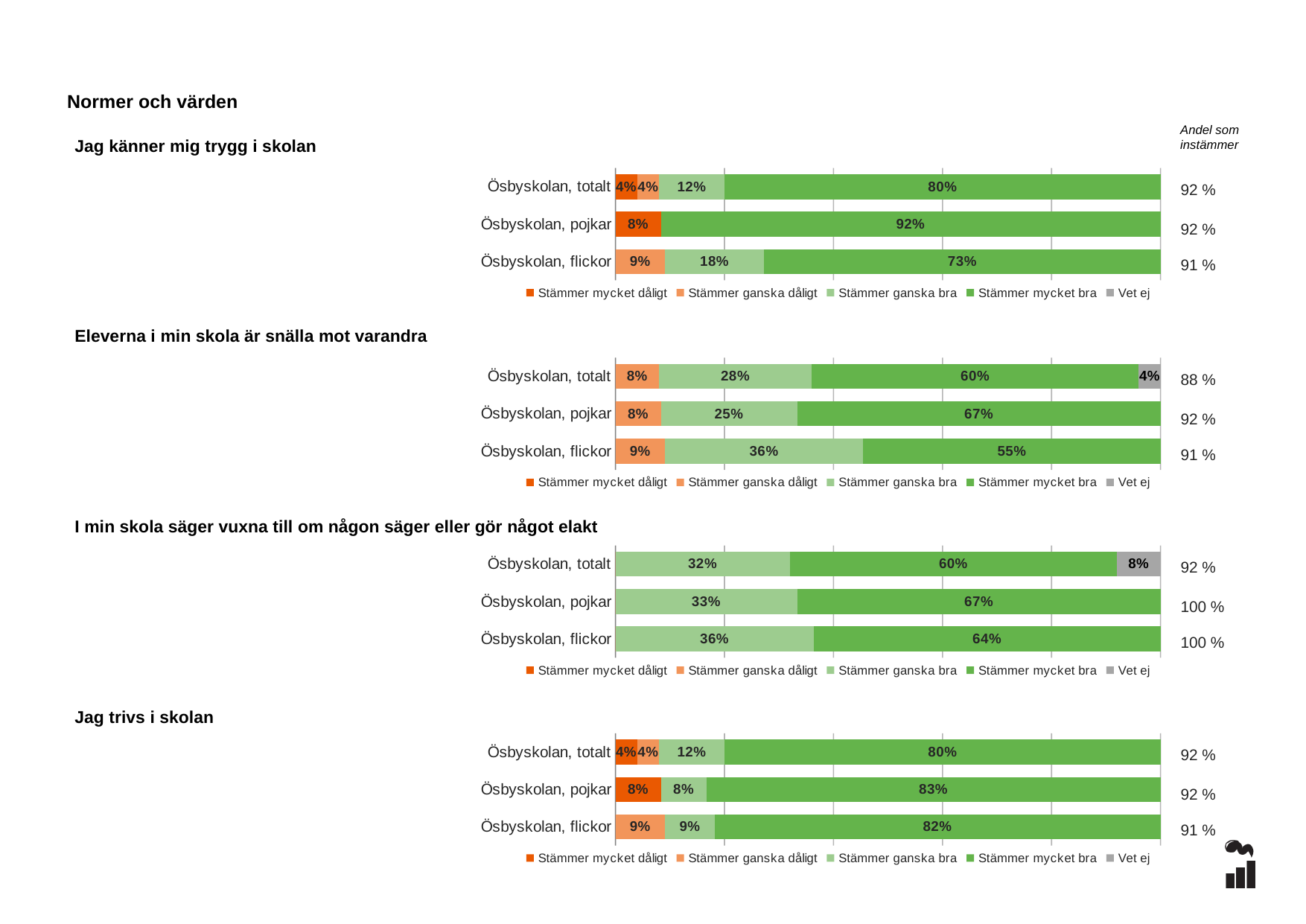
In the chart 'I min skola säger vuxna till om någon säger eller gör något elakt', what is the 'Vet ej' value for Ösbyskolan, totalt? 8% In the chart 'I min skola säger vuxna till om någon säger eller gör något elakt', which is larger: the 'Stämmer mycket bra' value for Ösbyskolan, pojkar or for Ösbyskolan, flickor? Ösbyskolan, pojkar In the chart 'Jag känner mig trygg i skolan', what is the 'Stämmer mycket bra' value for Ösbyskolan, pojkar? 92% In the chart 'Jag känner mig trygg i skolan', what is the 'Stämmer ganska bra' value for Ösbyskolan, flickor? 18% In the chart 'Jag trivs i skolan', which group has the lowest 'Stämmer mycket bra' value? Ösbyskolan, totalt In the chart 'Eleverna i min skola är snälla mot varandra', which group has the highest 'Stämmer mycket bra' value? Ösbyskolan, pojkar What type of chart is used for 'Eleverna i min skola är snälla mot varandra'? Stacked bar chart In the chart 'Jag trivs i skolan', what is the 'Stämmer mycket bra' value for Ösbyskolan, flickor? 82% How many series does the legend list for the chart 'Jag trivs i skolan'? 5 In the chart 'Eleverna i min skola är snälla mot varandra', what is the 'Vet ej' value for Ösbyskolan, totalt? 4% How many groups (bars) are shown in the chart 'Jag känner mig trygg i skolan'? 3 In the chart 'Eleverna i min skola är snälla mot varandra', what is the difference between the 'Stämmer ganska bra' values for Ösbyskolan, flickor and Ösbyskolan, pojkar? 11%